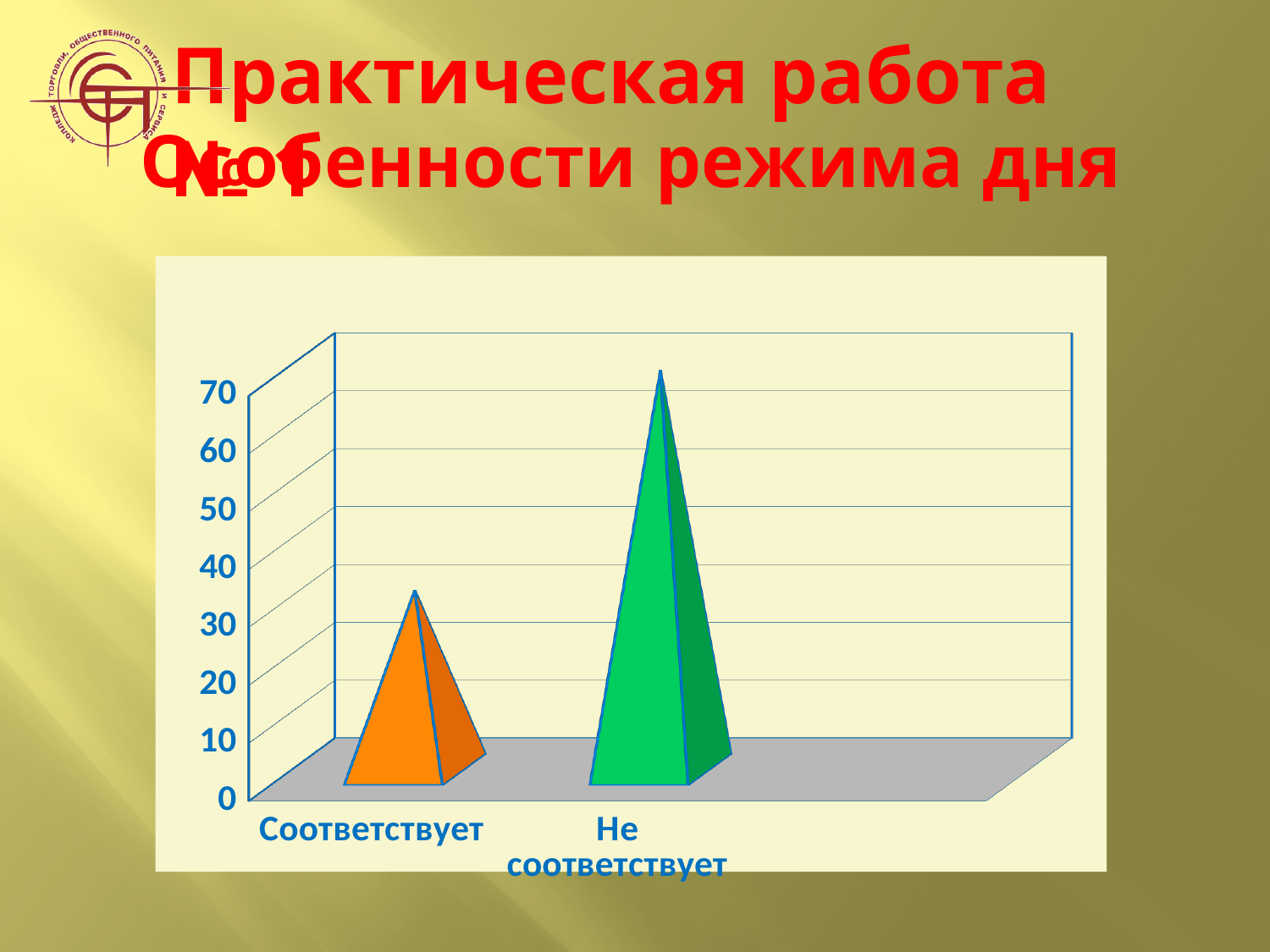
Which category has the lowest value in the chart? Соответствует Is the value for Не соответствует greater or less than 60? greater Do the values rise or fall from left to right along the x axis? rise What is the highest tick value shown on the vertical axis of the chart? 70 Which is larger: the value for Соответствует or the value for Не соответствует? Не соответствует Which category has the highest value in the chart? Не соответствует Is the value for Не соответствует greater or less than 50? greater What kind of chart is shown on the slide? bar chart Is the value for Соответствует greater or less than 40? less How many categories are shown on the x axis of the chart? 2 What colour is the bar for Не соответствует? green